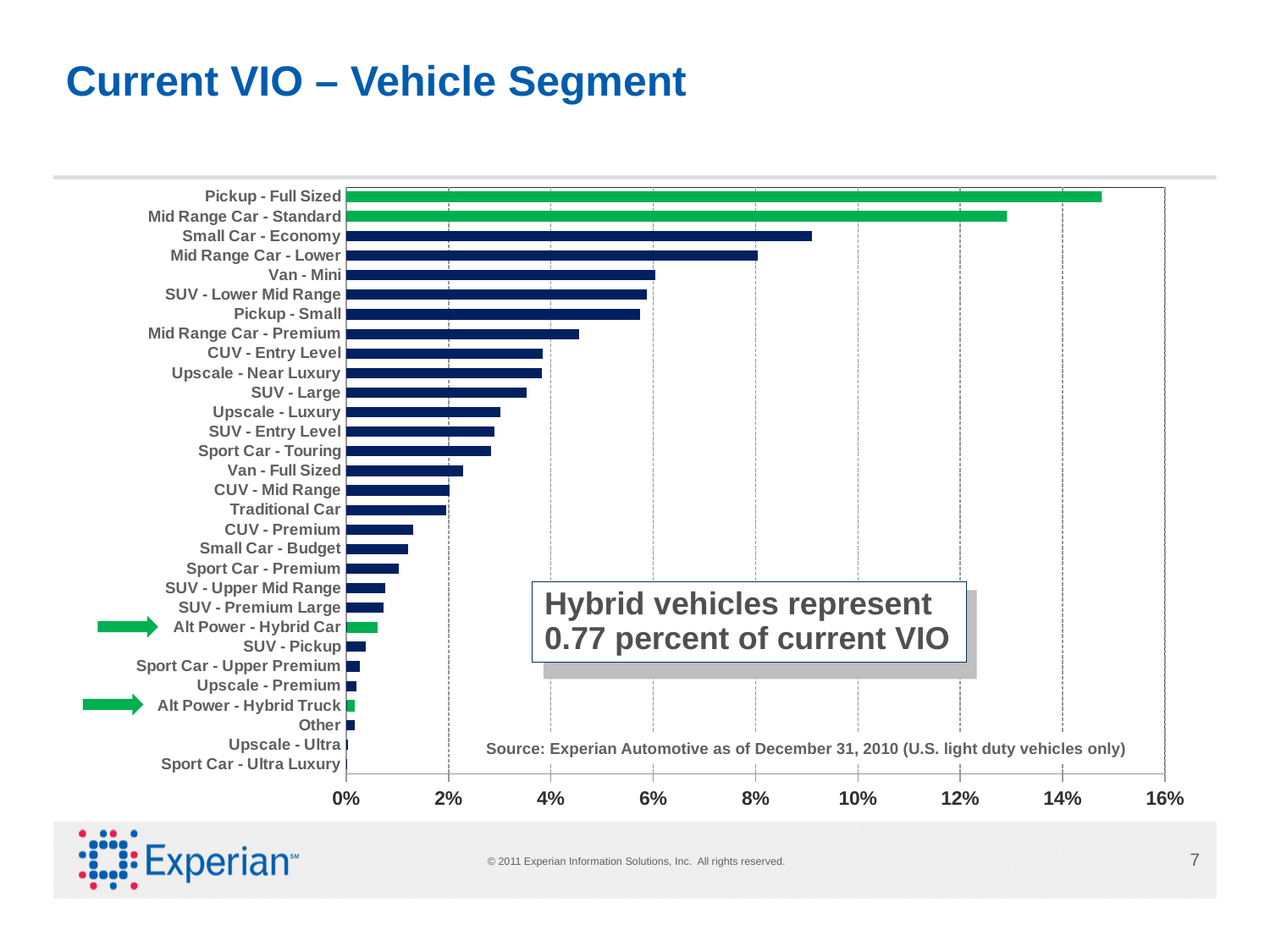
How many vehicle segments are listed on the chart? 30 Which is larger, the value for Upscale - Luxury or the value for Van - Full Sized? Upscale - Luxury Is the value for Small Car - Economy greater or less than 10%? less Which vehicle segment has the highest share of current VIO? Pickup - Full Sized Is the value for Mid Range Car - Standard greater or less than 12%? greater What colour is the bar for Alt Power - Hybrid Car? Green According to the callout on the chart, what percent of current VIO do hybrid vehicles represent? 0.77 percent Which is larger, the value for Small Car - Economy or the value for Mid Range Car - Lower? Small Car - Economy Is the value for Van - Mini greater or less than 8%? less What kind of chart is shown on the slide? Bar chart